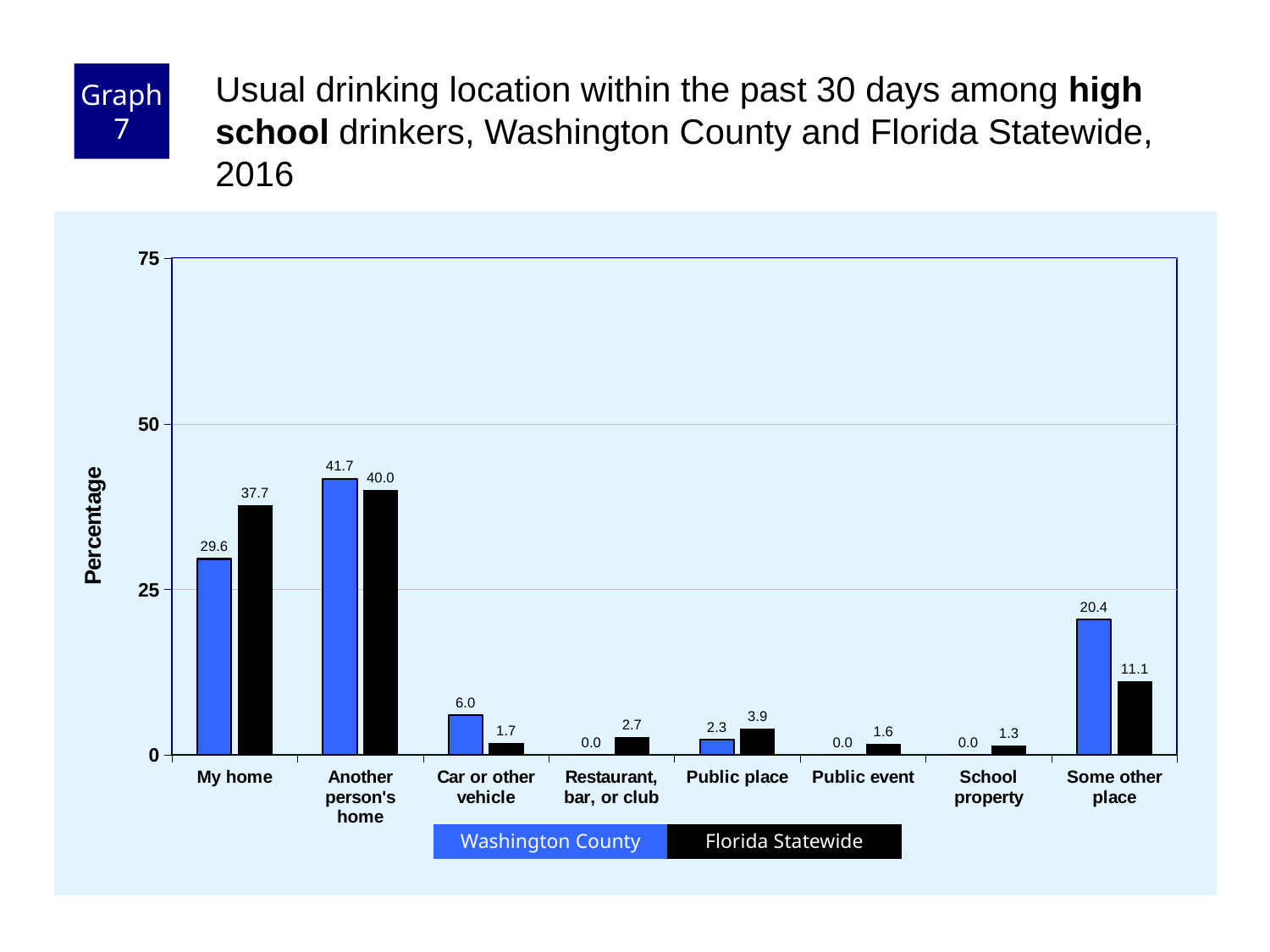
How many categories are shown on the x axis? 8 How many series does the legend list? 2 What is the difference between the Washington County and Florida Statewide values for "Some other place"? 9.3 Which category has the highest Washington County value? Another person's home What is the Washington County value for "Car or other vehicle"? 6.0 What is the Florida Statewide value for "Some other place"? 11.1 What is the difference between the Florida Statewide and Washington County values for "My home"? 8.1 For "Public place", which is larger: Washington County or Florida Statewide? Florida Statewide Is the Florida Statewide value for "Another person's home" greater or less than 25? greater What kind of chart is shown on the slide? Bar chart What is the Washington County value for "My home"? 29.6 Which category has the lowest Florida Statewide value? School property